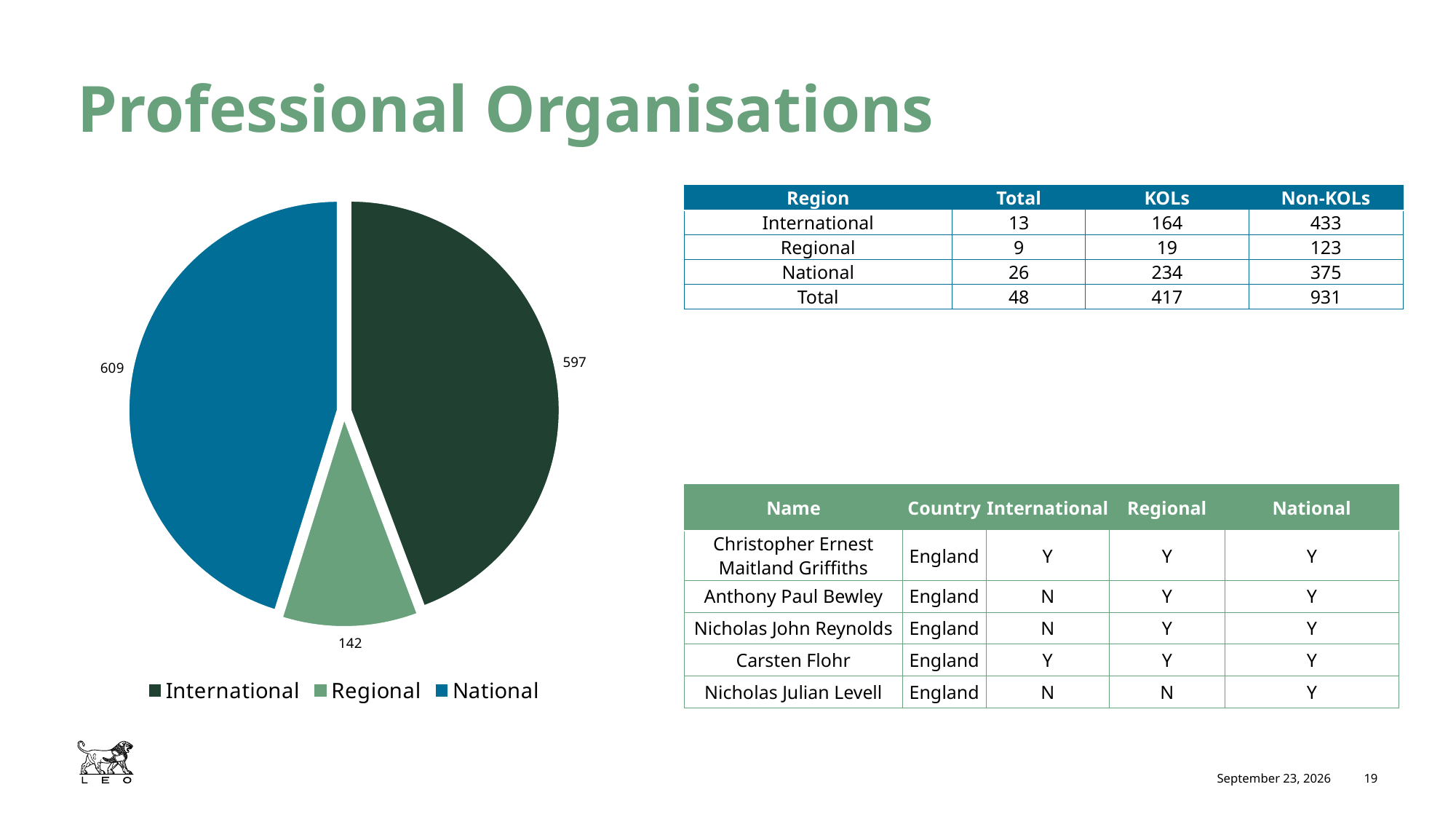
What is the value of the International slice in the pie chart? 597 Which category has the largest slice in the pie chart? National Which category has the smallest slice in the pie chart? Regional What is the difference between the International and Regional values in the pie chart? 455 What is the value of the National slice in the pie chart? 609 What colour is the National slice in the pie chart? blue How many slices does the pie chart have? 3 What is the value of the Regional slice in the pie chart? 142 What kind of chart is shown on the slide? pie chart What is the difference between the National and International values in the pie chart? 12 Which is larger in the pie chart, the National value or the International value? National